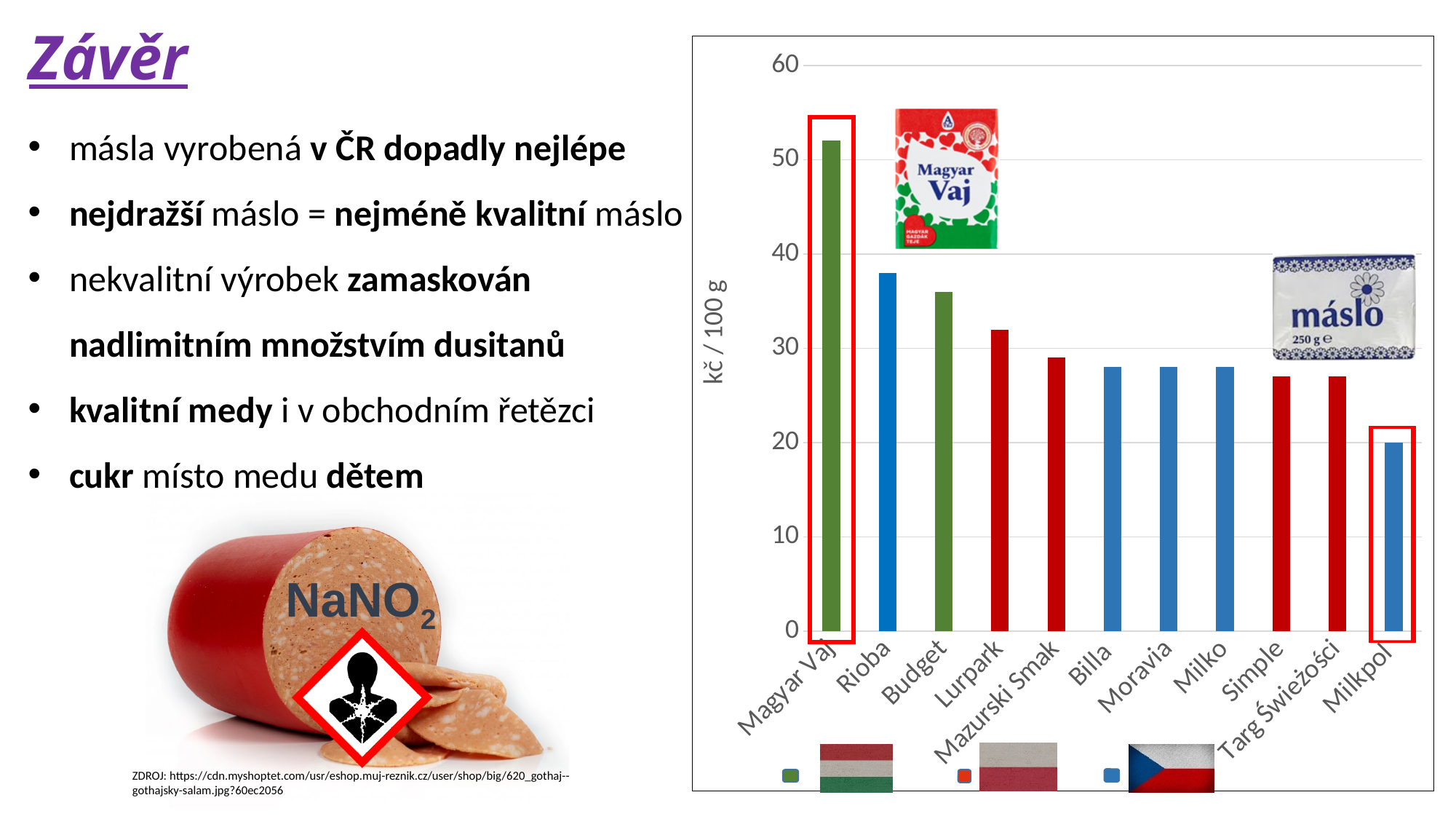
What is the label on the y axis of the chart? kč / 100 g What kind of chart is shown on the slide? bar chart Which brand has the highest price per 100 g in the chart? Magyar Vaj How many butter brands are shown on the x axis of the chart? 11 Do the bar values rise or fall from left to right along the x axis? fall Is the value for Milkpol greater or less than 30? less Is the value for Magyar Vaj greater or less than 50? greater Which brand has the lowest price per 100 g in the chart? Milkpol Which has the higher value, Rioba or Budget? Rioba Is the value for Lurpark greater or less than 30? greater Which has the higher value, Lurpark or Mazurski Smak? Lurpark